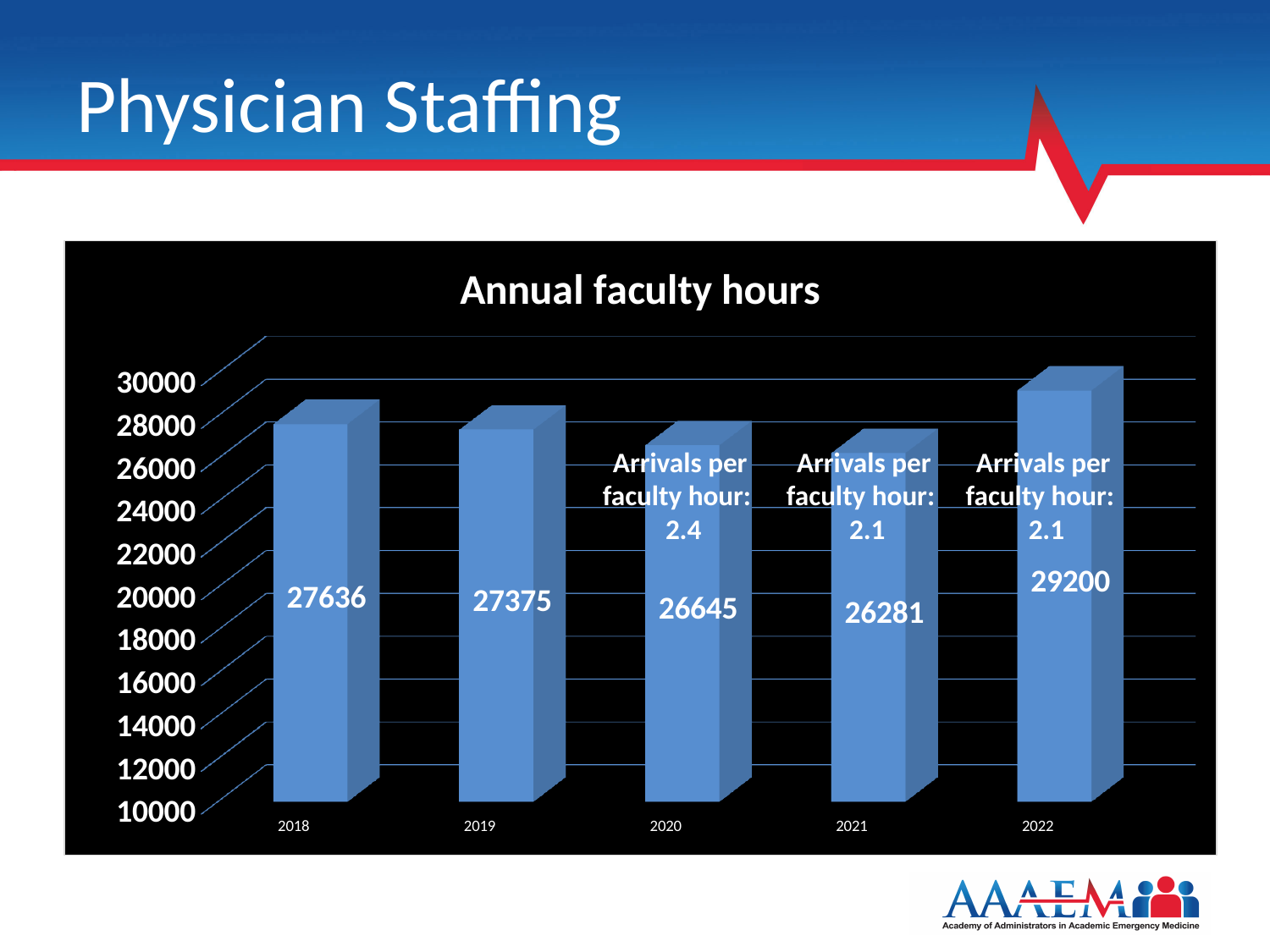
How many years are shown on the x axis of the chart? 5 What is the arrivals per faculty hour figure annotated for 2020? 2.4 What is the value for 2018 in the Annual faculty hours chart? 27636 Is the value for 2020 greater or less than 28000? less Which year has the highest annual faculty hours? 2022 What is the value for 2021 in the Annual faculty hours chart? 26281 What kind of chart is shown on the slide? bar chart Which year has more annual faculty hours, 2019 or 2020? 2019 What is the difference in annual faculty hours between 2022 and 2021? 2919 Which year has the lowest annual faculty hours? 2021 What is the difference in annual faculty hours between 2018 and 2019? 261 What is the value for 2022 in the Annual faculty hours chart? 29200